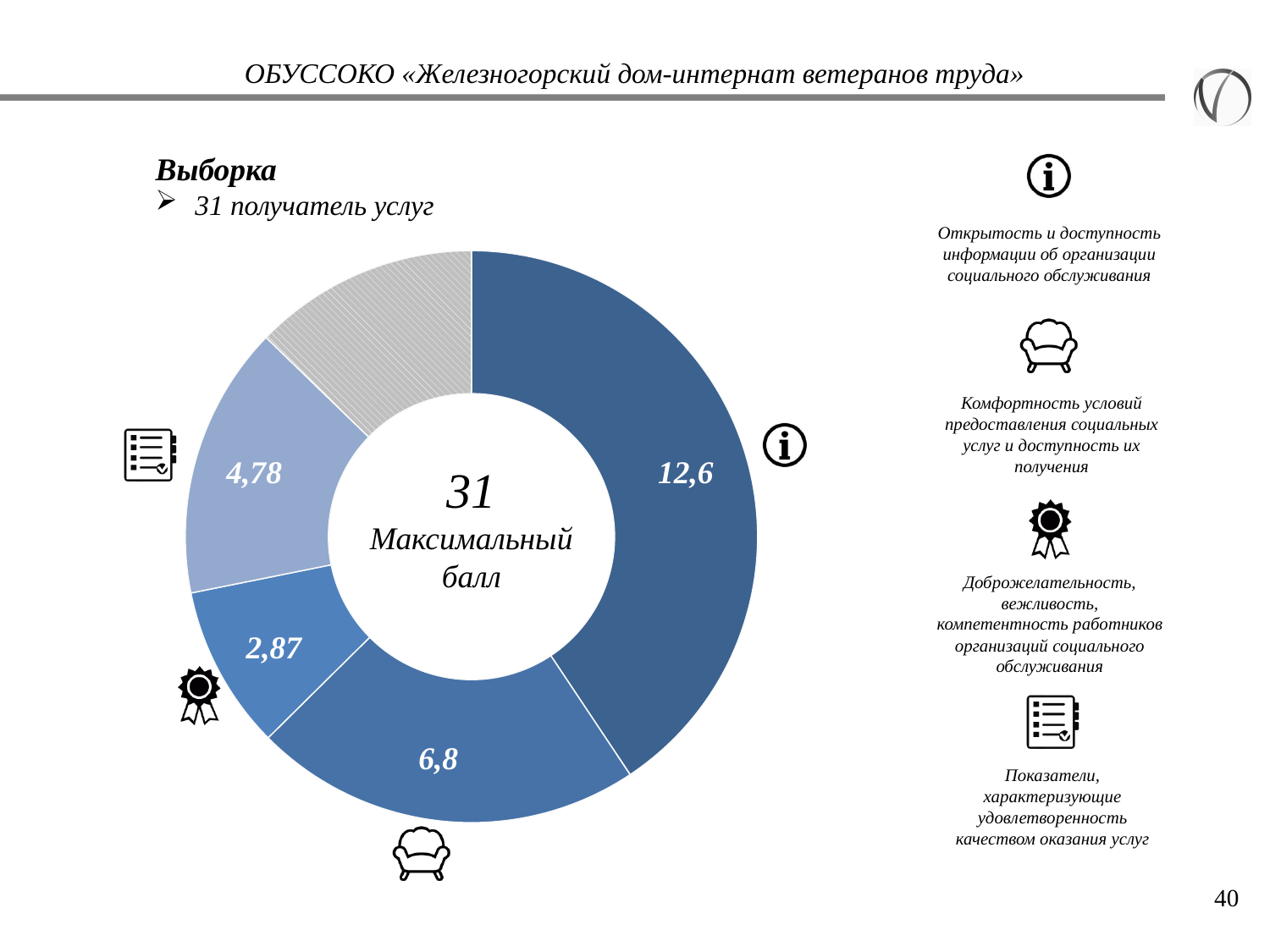
What value is shown for the segment marked with the armchair icon (Комфортность условий предоставления социальных услуг)? 6,8 What type of chart is shown on the slide? doughnut (pie) chart What is the sample size (Выборка) stated on the slide? 31 получатель услуг What value is shown for the segment marked with the checklist icon (Показатели, характеризующие удовлетворенность качеством оказания услуг)? 4,78 Which is larger: the value for the checklist icon segment or the medal icon segment? the checklist icon segment (4,78) Which labeled segment of the chart has the highest value? Открытость и доступность информации (12,6) What value is shown for the segment marked with the medal icon (Доброжелательность, вежливость, компетентность работников)? 2,87 How many segments of the chart have a printed data label? 4 Which labeled segment of the chart has the lowest value? Доброжелательность, вежливость, компетентность работников (2,87) What value is shown for the segment marked with the information icon (Открытость и доступность информации)? 12,6 What is the difference between the value for the information icon segment (12,6) and the armchair icon segment (6,8)? 5,8 What maximum score (Максимальный балл) is shown in the centre of the chart? 31